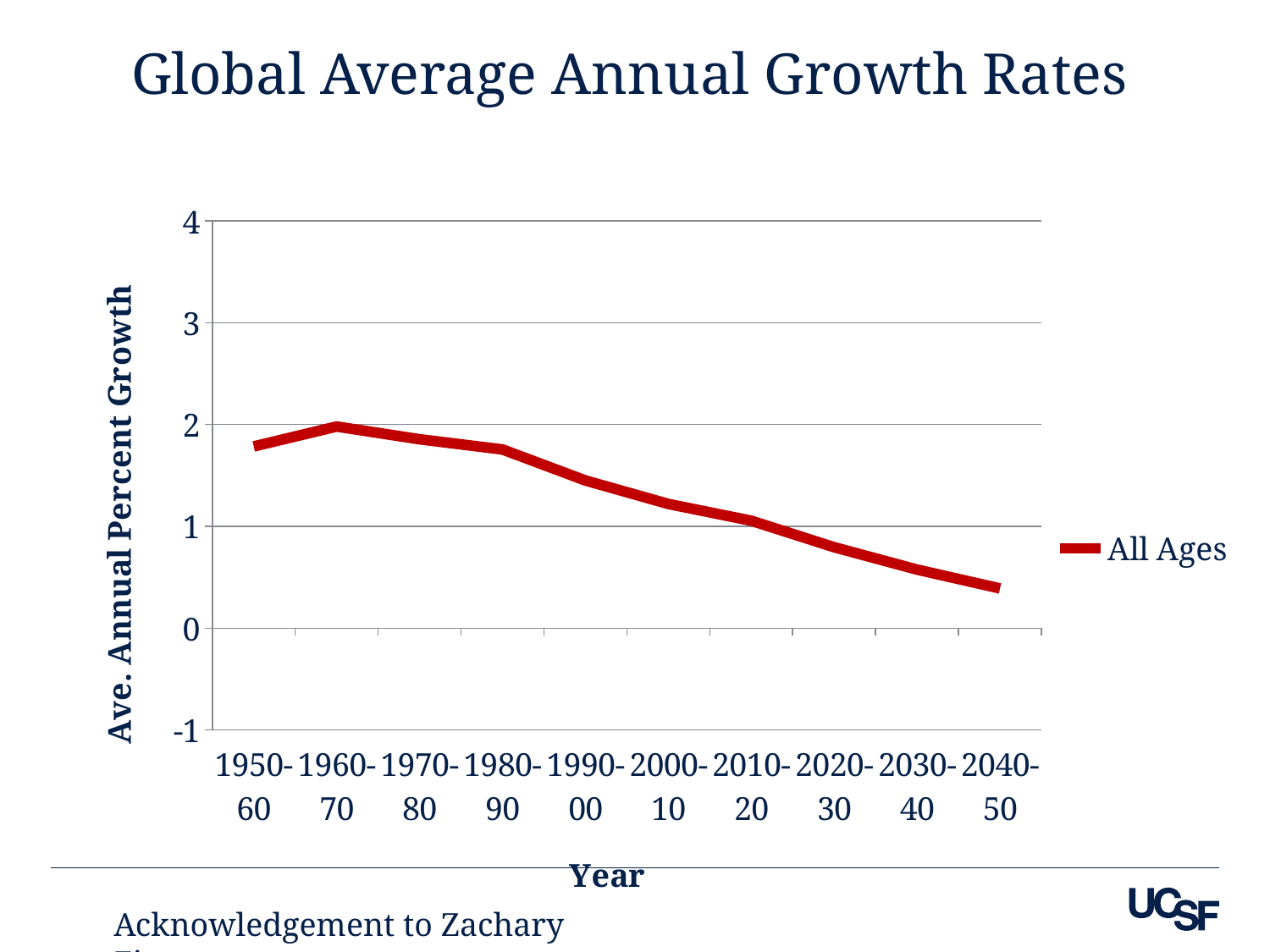
What is the name of the series shown in the legend? All Ages Which is larger, the value for 1950-60 or the value for 2030-40? 1950-60 Is the value for 2040-50 greater or less than 1? less Is the value for 1960-70 greater or less than 3? less Which period has the lowest average annual percent growth? 2040-50 Which period has the highest average annual percent growth? 1960-70 Do the values generally rise or fall from 1960-70 to 2040-50? fall What is the title of the chart? Global Average Annual Growth Rates How many series does the legend list? 1 What kind of chart is shown on the slide? Line chart How many time periods are plotted along the x axis? 10 Is the value for 1950-60 greater or less than 1? greater